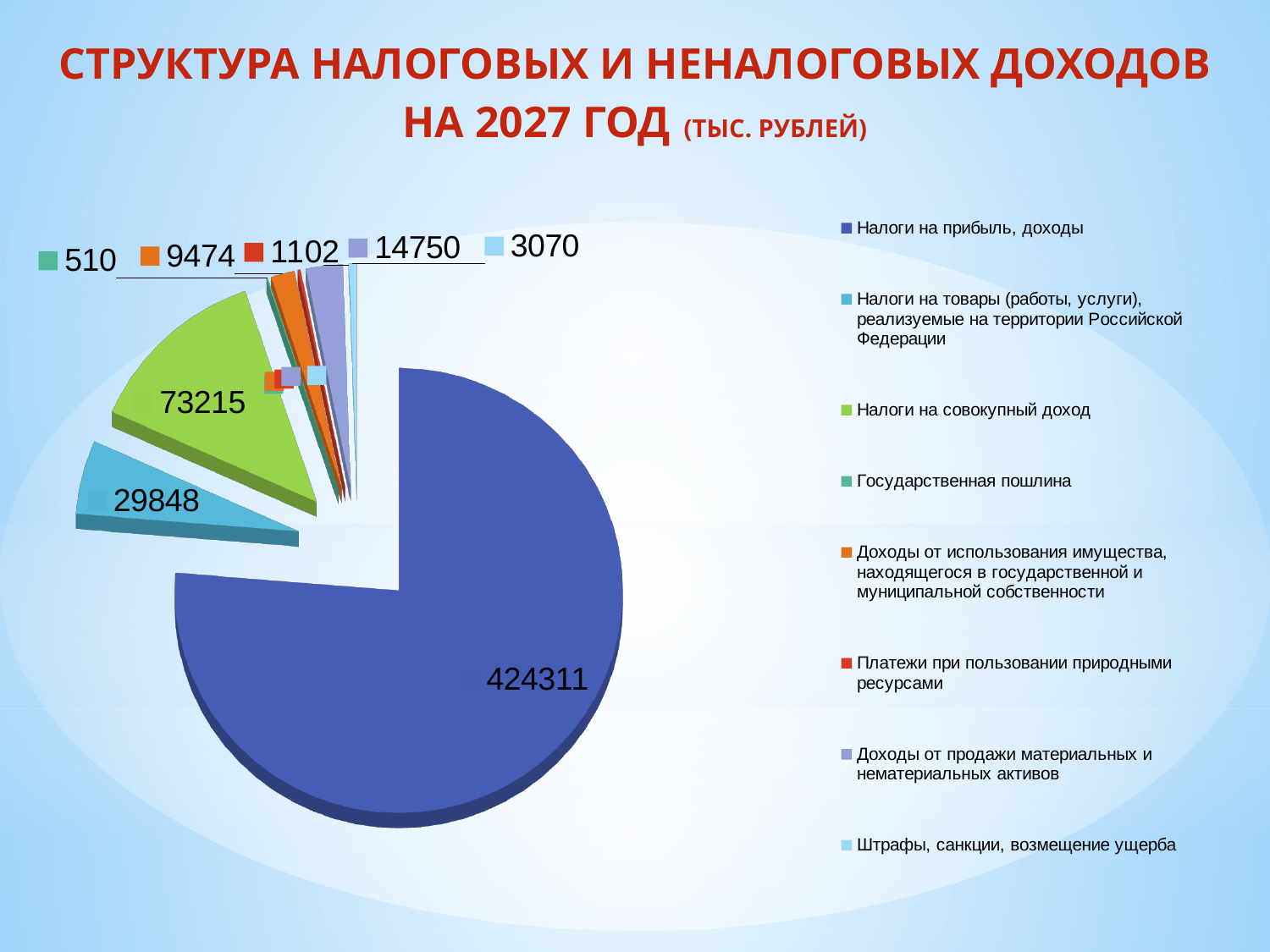
What is the value for Налоги на совокупный доход? 73215 What kind of chart is shown on the slide? Pie chart What is the value for Налоги на товары (работы, услуги), реализуемые на территории Российской Федерации? 29848 What is the value for Налоги на прибыль, доходы? 424311 How many categories does the legend list? 8 What is the difference between the values for Налоги на совокупный доход and Налоги на товары (работы, услуги), реализуемые на территории Российской Федерации? 43367 Which category has the smallest value? Государственная пошлина What is the value for Штрафы, санкции, возмещение ущерба? 3070 Which is larger: Доходы от использования имущества, находящегося в государственной и муниципальной собственности or Платежи при пользовании природными ресурсами? Доходы от использования имущества, находящегося в государственной и муниципальной собственности What unit is stated in the chart title? тыс. рублей Which category has the largest slice of the pie? Налоги на прибыль, доходы What is the value for Доходы от продажи материальных и нематериальных активов? 14750